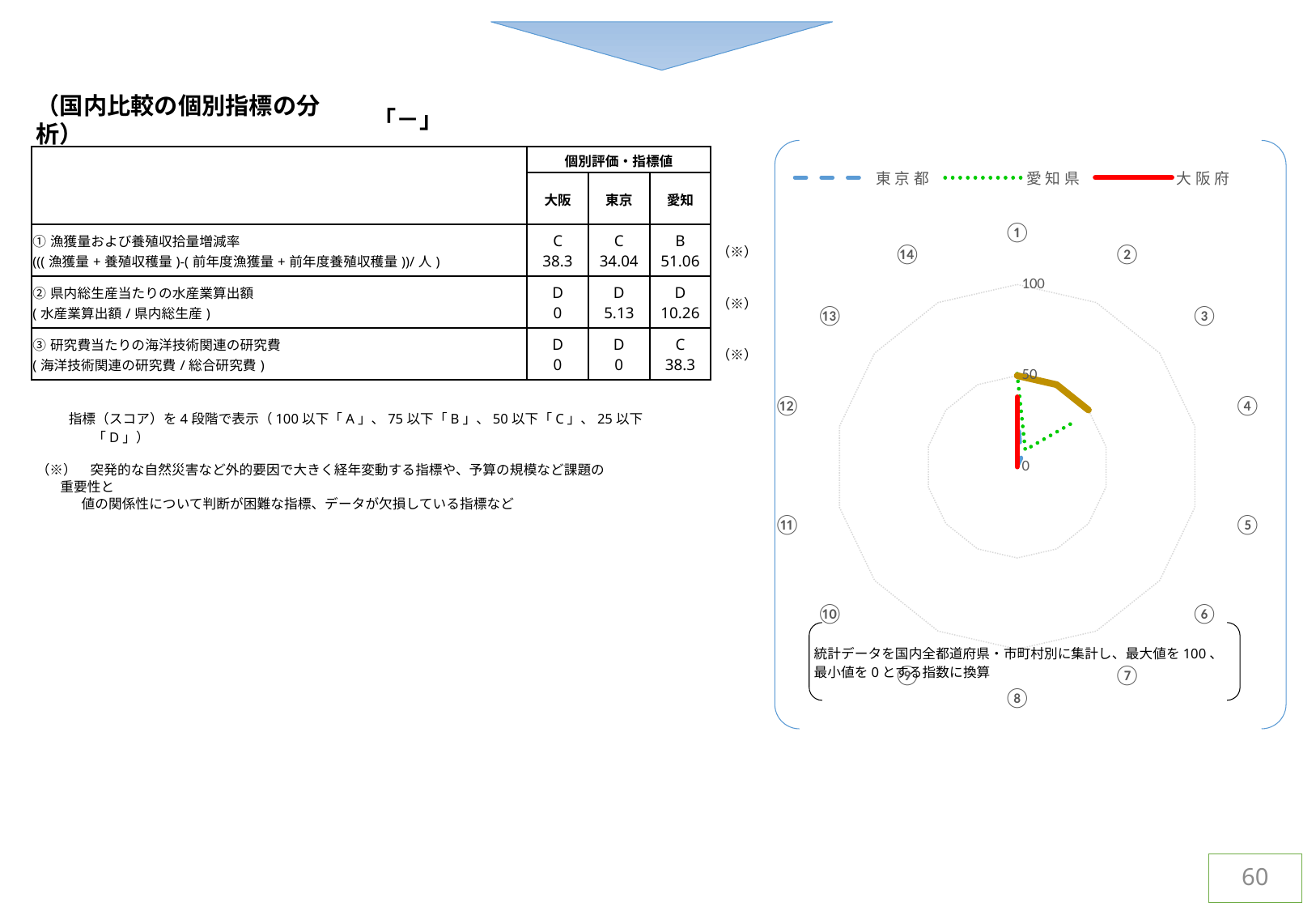
On the radar chart, is the value for 大阪府 on axis ① greater or less than 50? less How many series does the legend of the radar chart list? 3 How many numbered axes does the radar chart have? 14 On the radar chart, is the value for 愛知県 on axis ② greater or less than 50? less What kind of chart is shown on the right side of the slide? radar chart Which series are listed in the legend of the radar chart? 東京都, 愛知県, 大阪府 On the radar chart, is the value for 愛知県 on axis ③ greater or less than 50? less What is the highest value shown on the radar chart's scale? 100